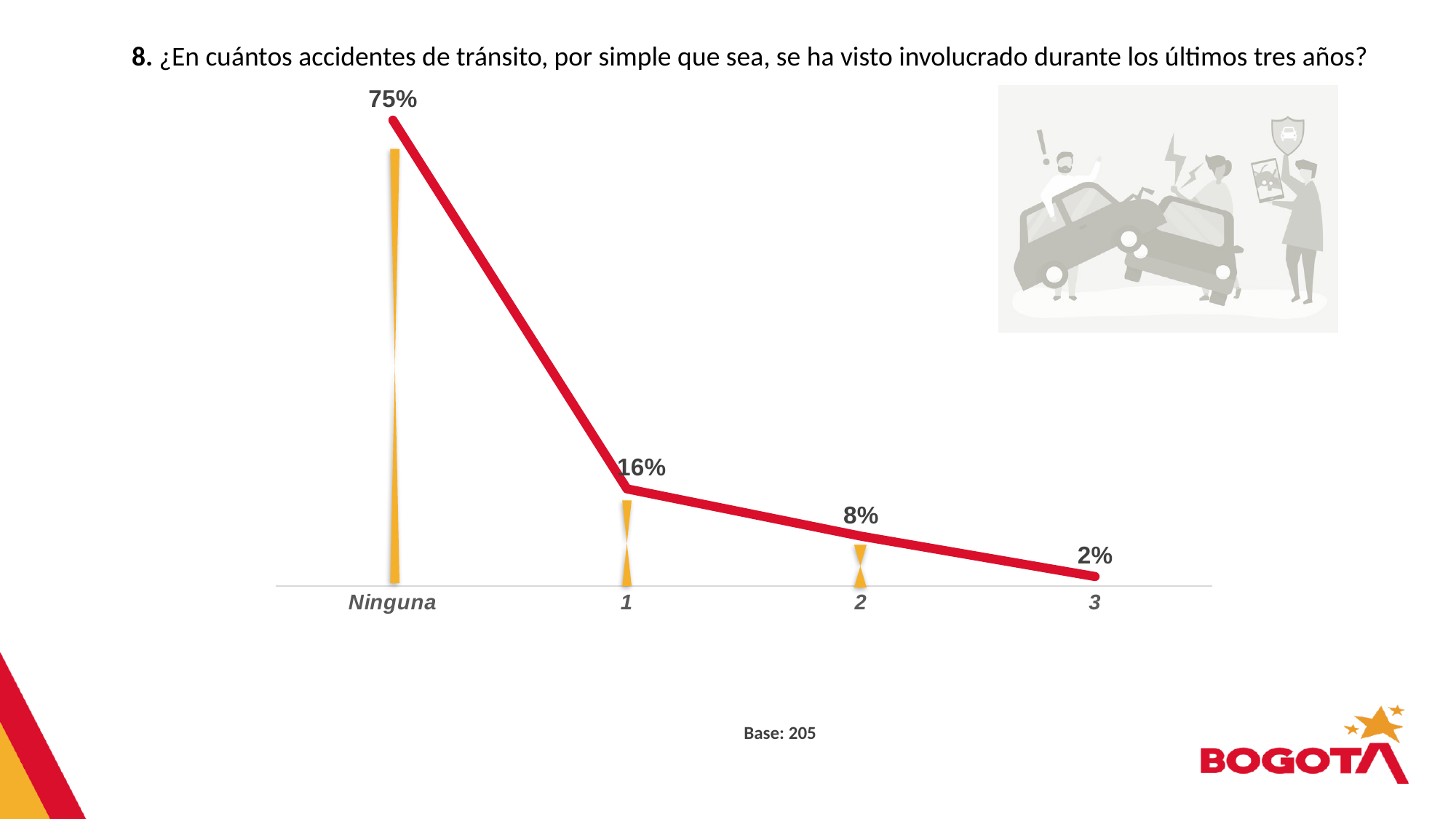
What is the difference between the values for Ninguna and 1? 59% How many categories are shown on the x axis? 4 Which category has the highest value? Ninguna Do the values rise or fall from Ninguna to 3 along the x axis? fall What is the value for category 2? 8% What is the value for category 1? 16% What is the difference between the values for 1 and 2? 8% What base (number of respondents) is stated below the chart? 205 Which is larger, the value for 2 or the value for 3? 2 Which category has the lowest value? 3 What is the value for category 3? 2% What is the value for Ninguna? 75%